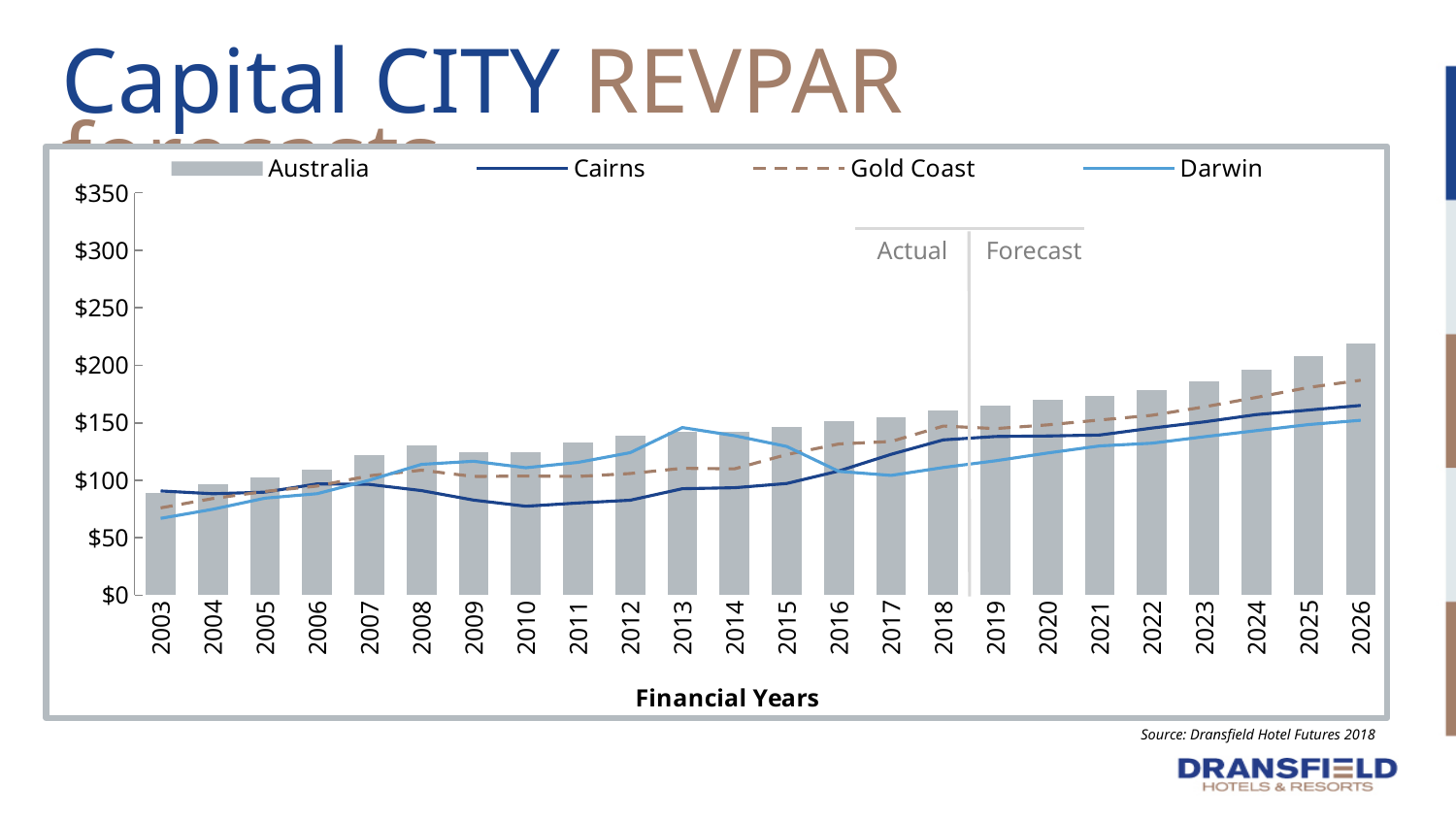
How many financial years are shown on the x axis? 24 Which series is drawn as a dashed line? Gold Coast Is the Australia value for 2026 greater or less than $200? greater Do the Australia bars generally rise or fall from 2003 to 2026? rise Which year has the lowest Australia bar? 2003 Is the Gold Coast value for 2026 greater or less than $200? less In 2013, which is higher, Darwin or Cairns? Darwin What kind of chart is this? Combined bar and line chart Is the Cairns value for 2010 greater or less than $100? less Which year has the highest Australia bar? 2026 How many series does the legend list? 4